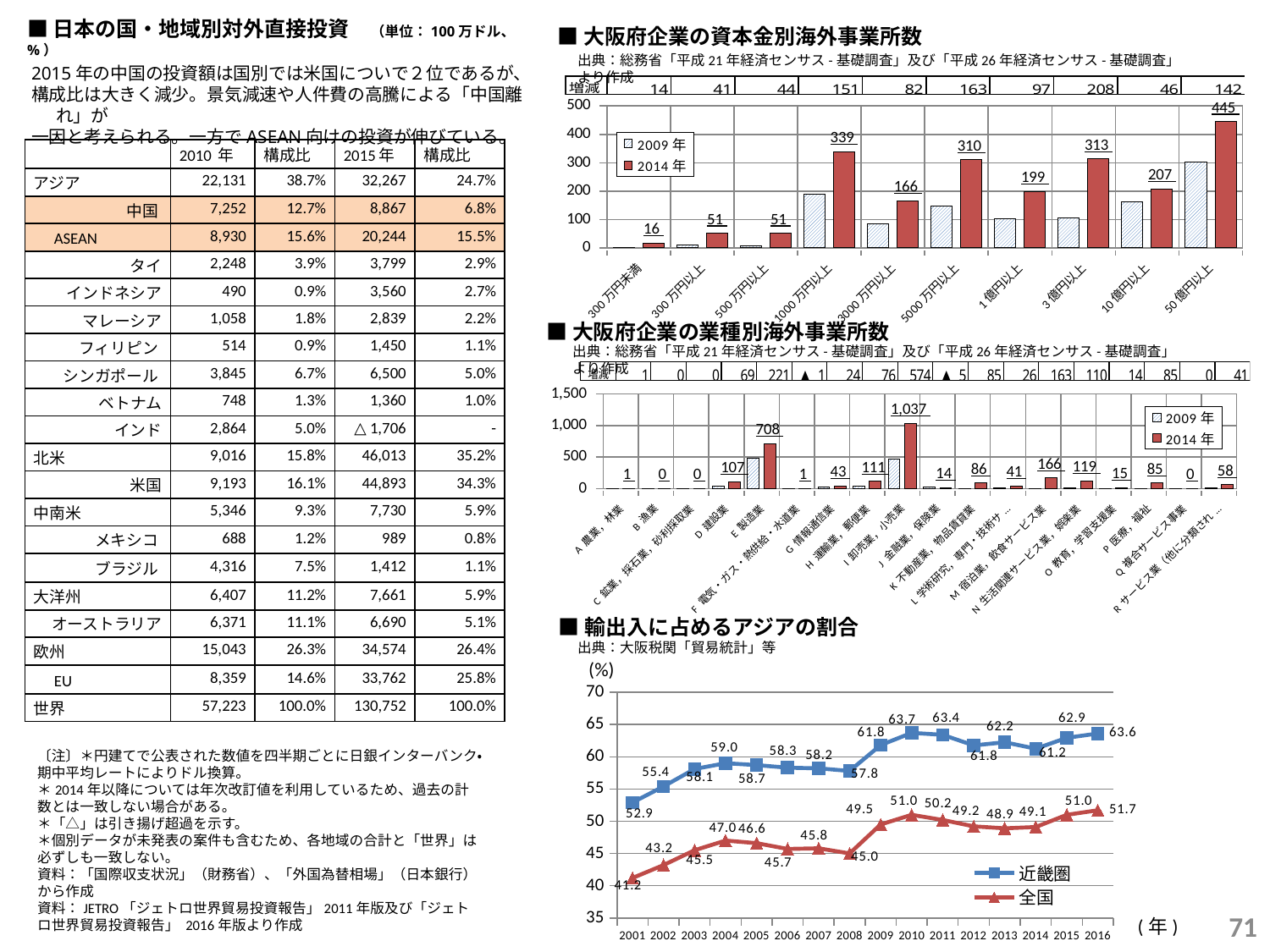
In the chart titled 輸出入に占めるアジアの割合, which series is higher in 2010, 近畿圏 or 全国? 近畿圏 In the chart titled 大阪府企業の資本金別海外事業所数, which capital-size category has the highest 2014年 value? 50億円以上 In the chart titled 輸出入に占めるアジアの割合, which year has the highest 近畿圏 value? 2010 In the chart titled 大阪府企業の業種別海外事業所数, what is the 2014年 value for I 卸売業，小売業? 1,037 In the chart titled 輸出入に占めるアジアの割合, what is the 全国 value for 2001? 41.2 In the chart titled 輸出入に占めるアジアの割合, what is the 近畿圏 value for 2016? 63.6 In the chart titled 大阪府企業の資本金別海外事業所数, how many series does the legend list? 2 In the chart titled 大阪府企業の業種別海外事業所数, what kind of chart is it? Bar chart In the chart titled 輸出入に占めるアジアの割合, what is the difference between the 近畿圏 and 全国 values in 2016? 11.9 In the chart titled 大阪府企業の資本金別海外事業所数, what is the 2014年 value for 1000万円以上? 339 In the chart titled 大阪府企業の業種別海外事業所数, what is the 2014年 value for E 製造業? 708 In the chart titled 大阪府企業の資本金別海外事業所数, what is the 2014年 value for the 50億円以上 category? 445